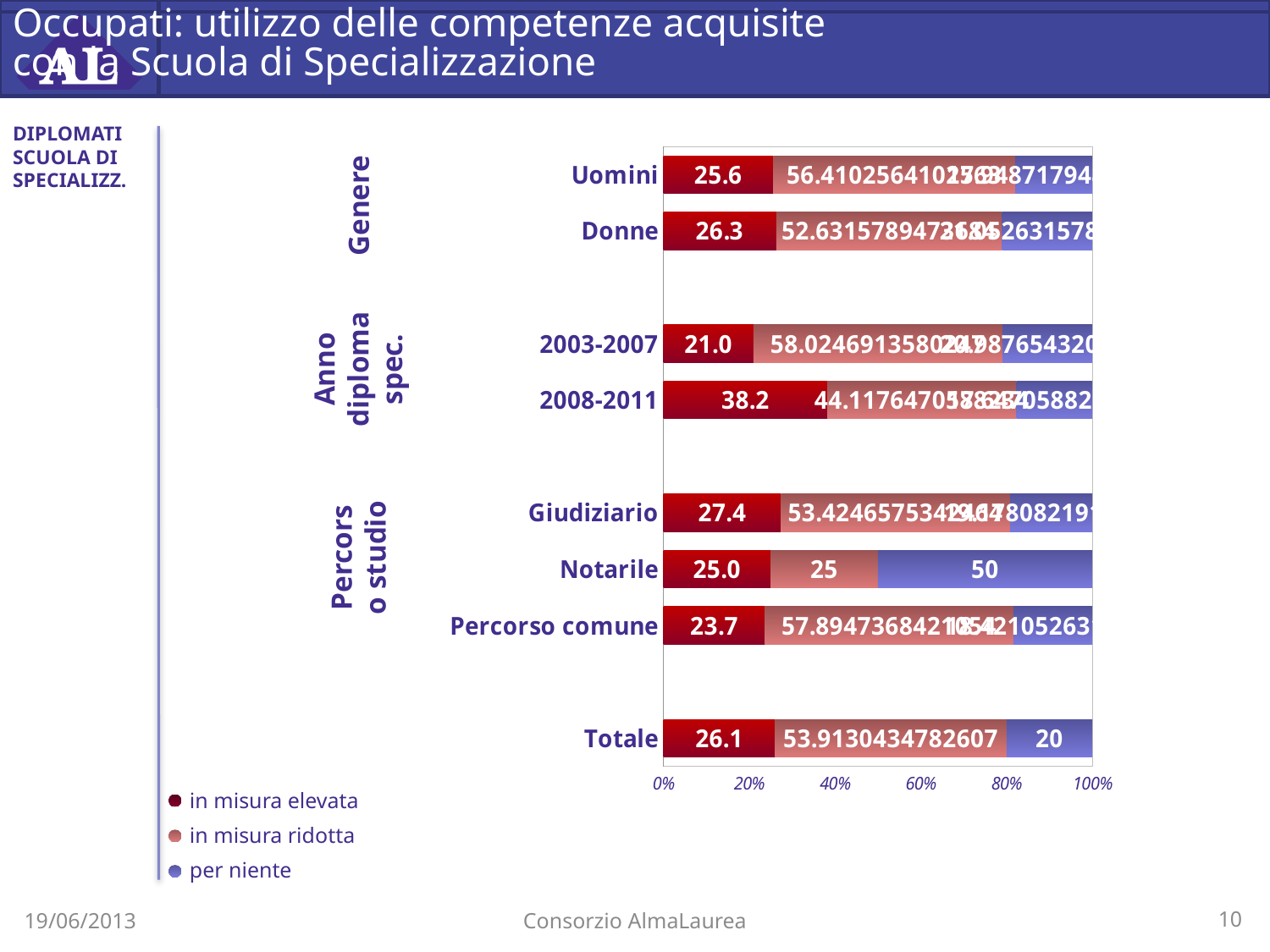
How many categories (bars) are plotted in the chart? 8 Which has the larger 'in misura elevata' value, Donne or Uomini? Donne What is the value of 'per niente' for Totale? 20 What kind of chart is shown on the slide? bar chart What is the value of 'in misura elevata' for Uomini? 25.6 How many series does the legend list? 3 Which category has the lowest value for 'in misura elevata'? 2003-2007 Which category has the highest value for 'in misura elevata'? 2008-2011 What is the value of 'per niente' for Notarile? 50 What is the value of 'in misura elevata' for 2008-2011? 38.2 Is the 'in misura ridotta' value for Uomini greater or less than 40%? greater What is the difference between the 'in misura elevata' values for 2008-2011 and 2003-2007? 17.2